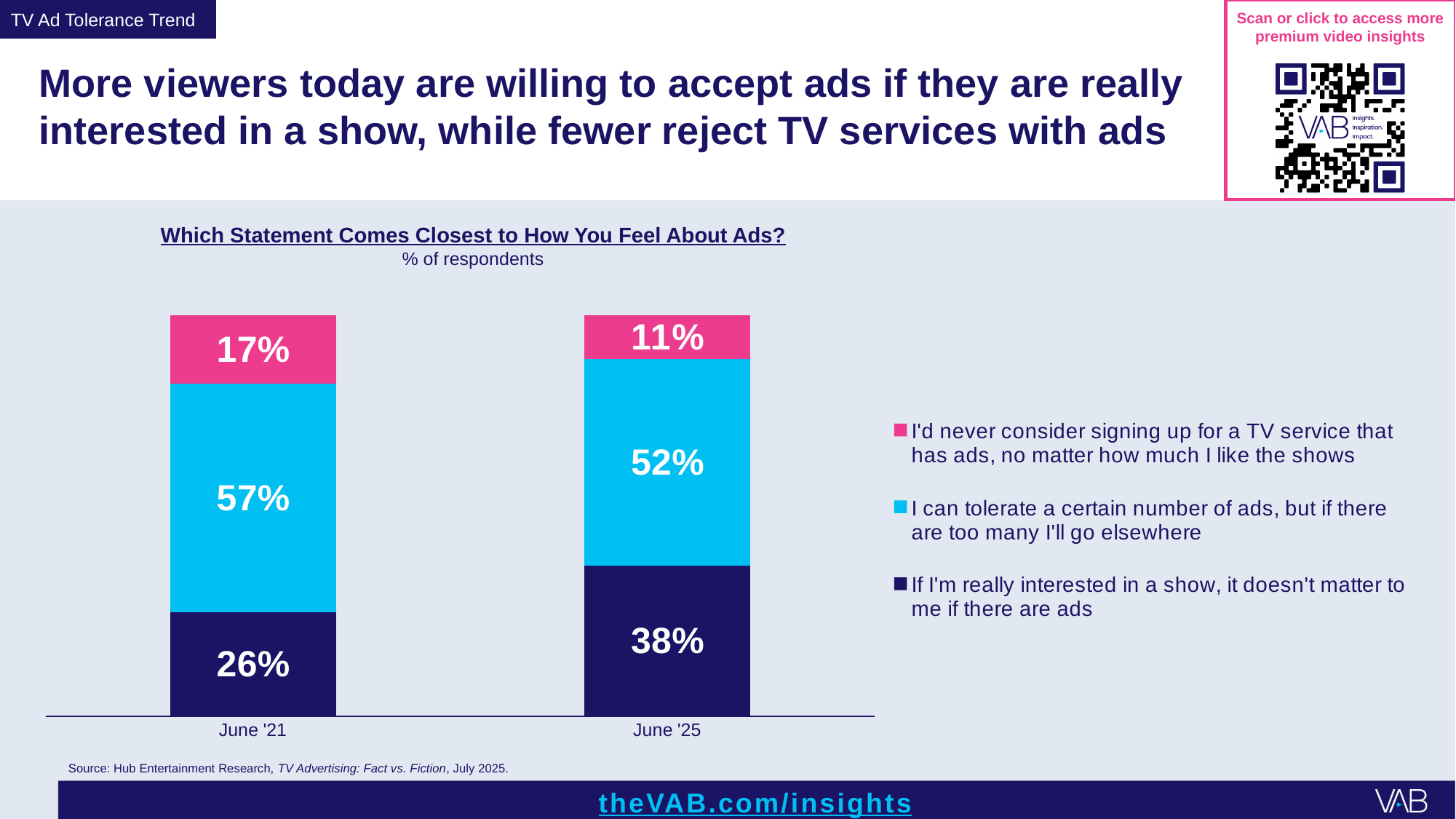
What percentage of respondents in June '25 said they can tolerate a certain number of ads but will go elsewhere if there are too many? 52% What percentage of respondents in June '21 said that if they're really interested in a show, it doesn't matter if there are ads? 26% Which period has the larger share of respondents who can tolerate a certain number of ads, June '21 or June '25? June '21 Which statement had the lowest share of respondents in June '21? I'd never consider signing up for a TV service that has ads, no matter how much I like the shows How many statements does the legend list? 3 What percentage of respondents in June '25 said that if they're really interested in a show, it doesn't matter if there are ads? 38% By how many percentage points did the share saying they'd never consider a TV service with ads fall from June '21 to June '25? 6 percentage points By how many percentage points did the share saying ads don't matter if they're really interested in a show change from June '21 to June '25? 12 percentage points What percentage of respondents in June '21 said they'd never consider signing up for a TV service that has ads? 17% What type of chart is used to show how respondents feel about ads? Stacked bar chart How many time periods are shown on the x axis of the chart? 2 Which statement had the highest share of respondents in June '25? I can tolerate a certain number of ads, but if there are too many I'll go elsewhere